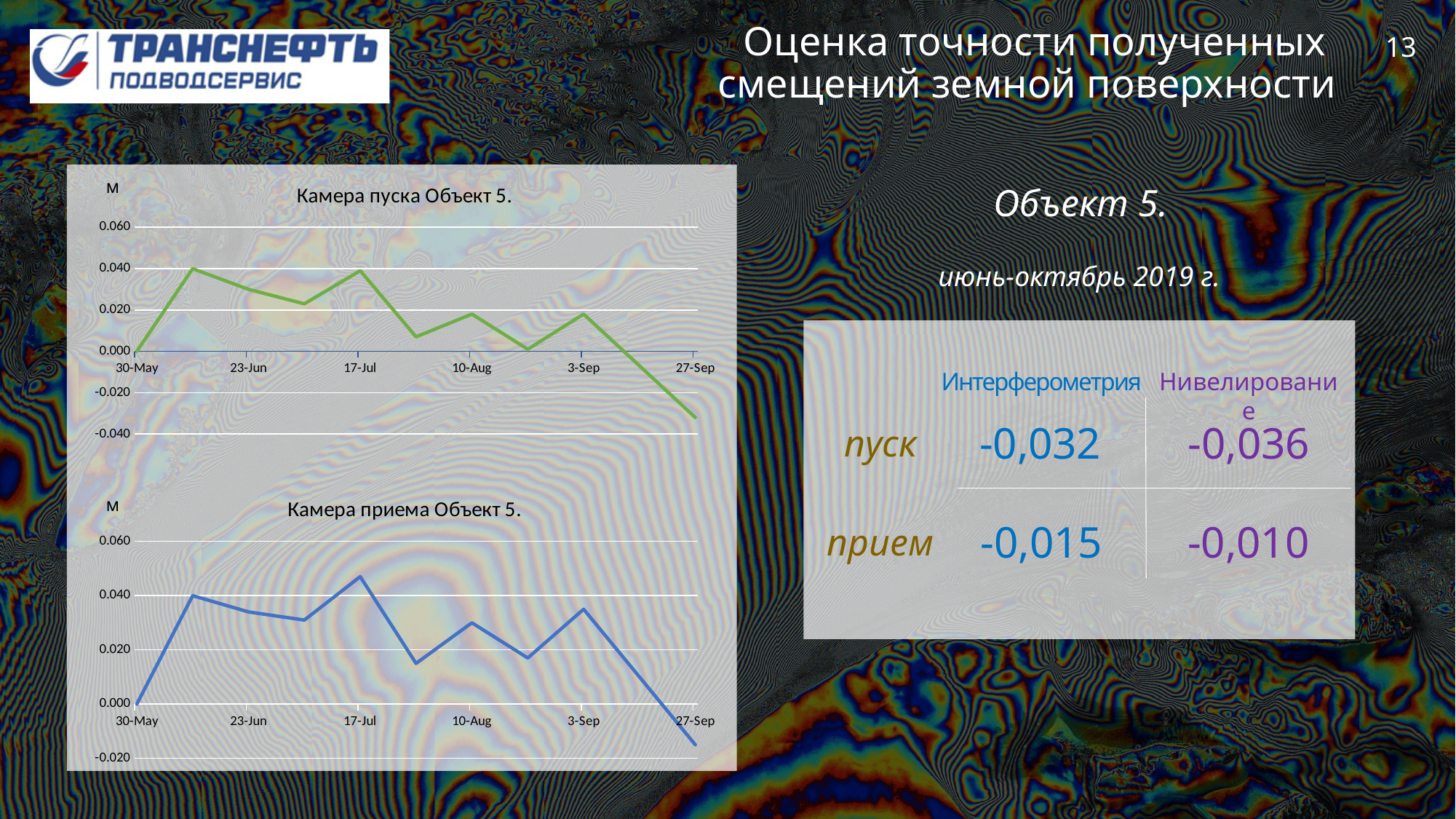
In the chart "Камера приема Объект 5.", at which date is the highest value? 17-Jul In the chart "Камера пуска Объект 5.", is the value at 27-Sep greater or less than -0.020? less In the chart "Камера приема Объект 5.", is the value at 27-Sep greater or less than 0.000? less In the chart "Камера пуска Объект 5.", what is the value at 30-May? 0.000 What kind of chart is "Камера пуска Объект 5."? line chart What unit is shown on the vertical axis of the chart "Камера пуска Объект 5."? м In the chart "Камера пуска Объект 5.", is the value at 17-Jul greater or less than 0.020? greater In the chart "Камера приема Объект 5.", does the value rise or fall between 3-Sep and 27-Sep? fall In the chart "Камера приема Объект 5.", which is larger, the value at 17-Jul or the value at 3-Sep? 17-Jul In the chart "Камера пуска Объект 5.", at which date is the lowest value? 27-Sep In the chart "Камера пуска Объект 5.", which is larger, the value at 17-Jul or the value at 10-Aug? 17-Jul